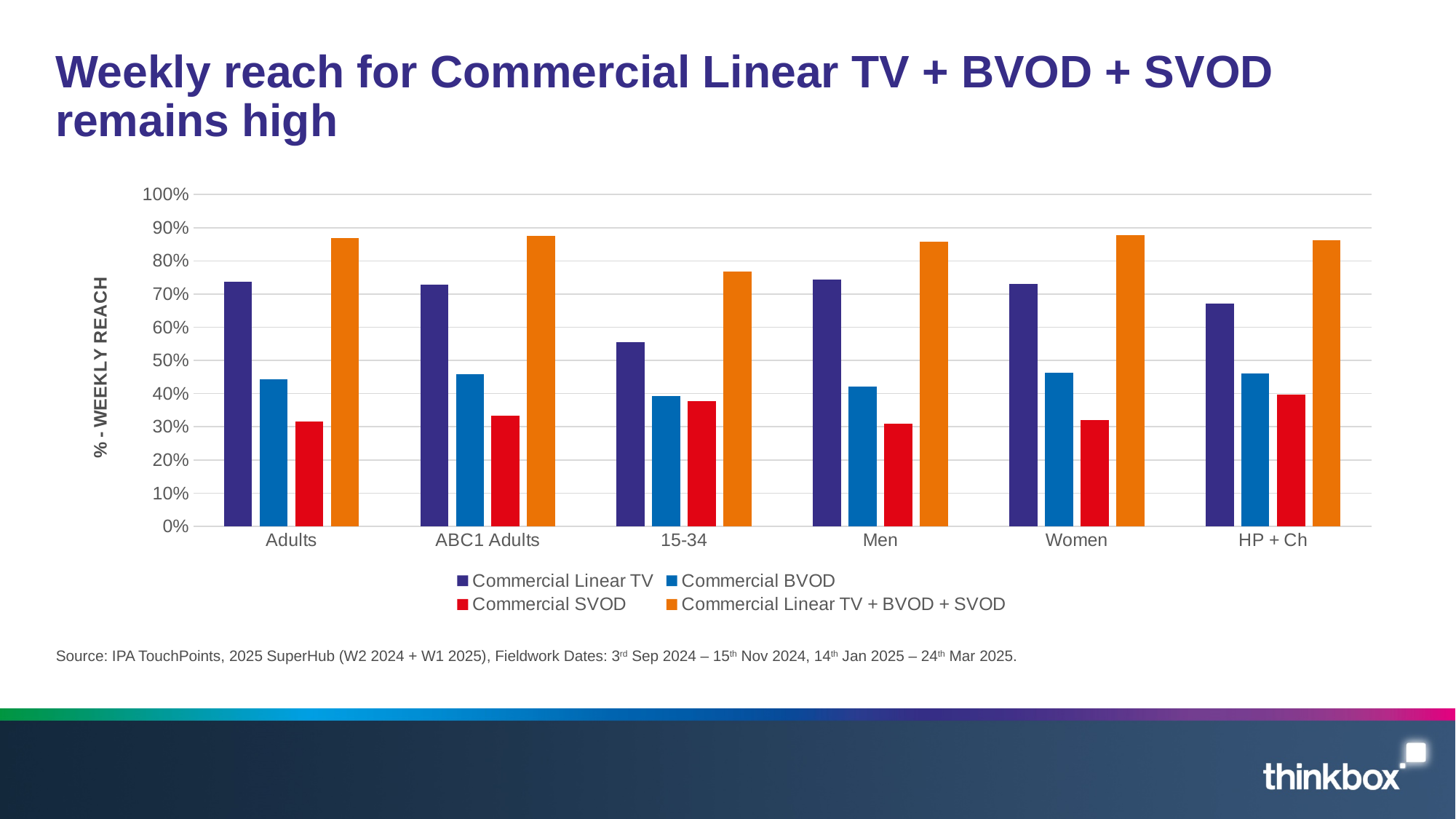
Is the Commercial SVOD value for Adults greater or less than 40%? less Is the Commercial Linear TV + BVOD + SVOD value for Women greater or less than 80%? greater Which audience has the lowest value for Commercial Linear TV + BVOD + SVOD? 15-34 Which audience has the lowest value for Commercial Linear TV? 15-34 How many series does the legend list? 4 What is the label on the vertical axis? % - WEEKLY REACH What kind of chart is shown on the slide? Bar chart Is the Commercial BVOD value for 15-34 greater or less than 50%? less How many audience categories are shown on the x axis? 6 Which is larger: the Commercial Linear TV value for Adults or for 15-34? Adults For Men, which is larger: Commercial Linear TV or Commercial BVOD? Commercial Linear TV